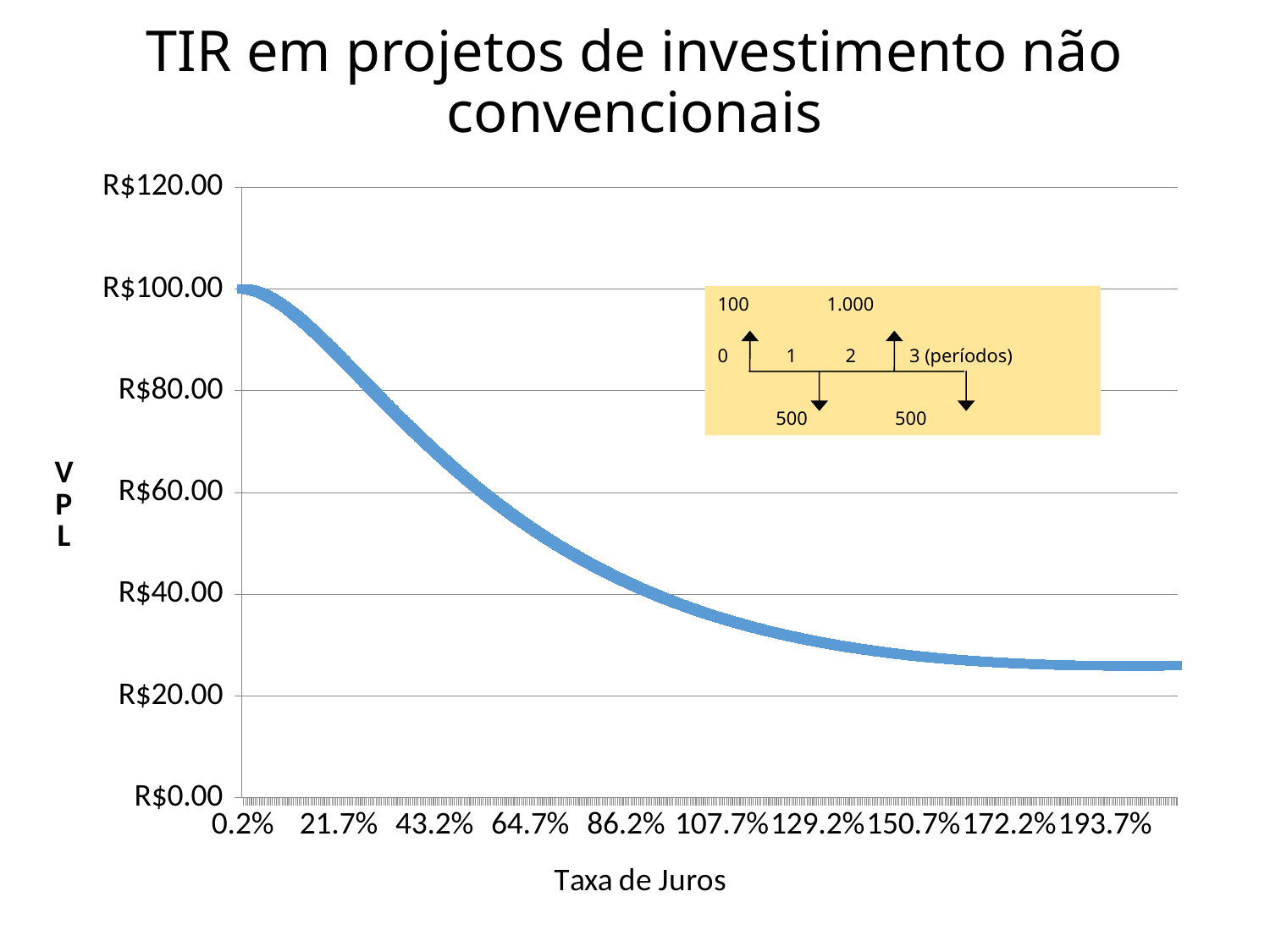
Is the VPL value at 150.7% greater or less than R$40.00? less At which labelled interest rate on the x axis is the VPL highest? 0.2% Is the VPL value at 107.7% greater or less than R$40.00? less What is the title of the x axis? Taxa de Juros Is the VPL value at 0.2% greater or less than R$80.00? greater Which has the larger VPL value: 21.7% or 129.2%? 21.7% Do the VPL values rise or fall as Taxa de Juros increases along the x axis? fall What is the title of the y axis? VPL What kind of chart is shown on the slide? line chart